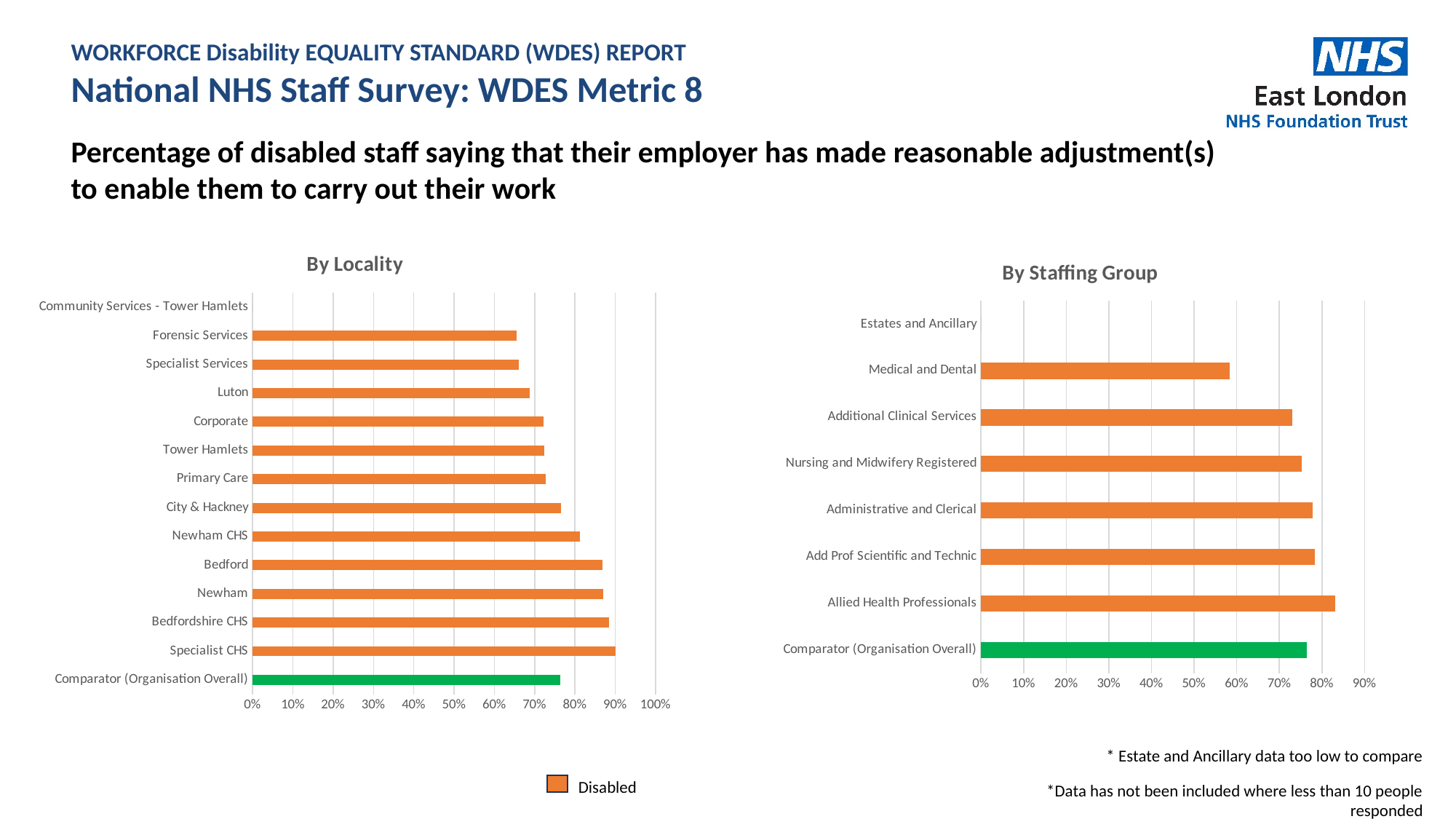
In the "By Staffing Group" chart, is the value for Allied Health Professionals greater or less than 80%? greater How many categories are listed on the vertical axis of the "By Staffing Group" chart? 8 In the "By Locality" chart, is the value for Specialist CHS greater or less than 80%? greater What is the single entry shown in the legend below the charts? Disabled In the "By Locality" chart, is the value for Forensic Services greater or less than 70%? less What kind of chart is the "By Locality" chart? bar chart In the "By Staffing Group" chart, which is larger, Additional Clinical Services or Medical and Dental? Additional Clinical Services In the "By Locality" chart, which is larger, Newham CHS or Luton? Newham CHS In the "By Staffing Group" chart, which staffing group has the highest value? Allied Health Professionals How many categories are listed on the vertical axis of the "By Locality" chart? 14 In the "By Staffing Group" chart, which staffing group with a plotted bar has the lowest value? Medical and Dental